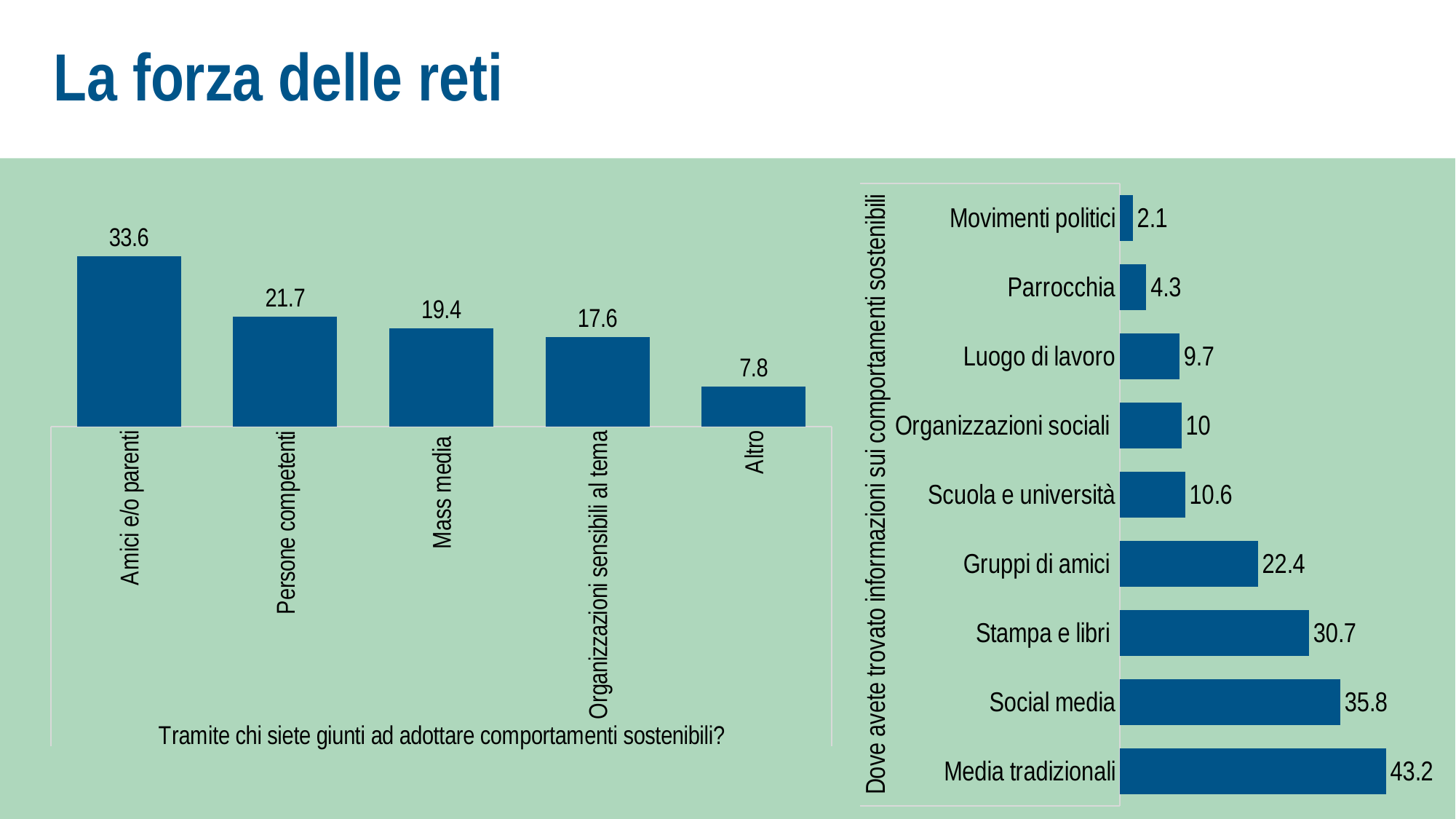
In the left chart 'Tramite chi siete giunti ad adottare comportamenti sostenibili?', how many categories are shown? 5 In the left chart 'Tramite chi siete giunti ad adottare comportamenti sostenibili?', what is the difference between Amici e/o parenti and Persone competenti? 11.9 In the right chart 'Dove avete trovato informazioni sui comportamenti sostenibili', which category has the lowest value? Movimenti politici In the right chart 'Dove avete trovato informazioni sui comportamenti sostenibili', what is the value for Stampa e libri? 30.7 In the right chart 'Dove avete trovato informazioni sui comportamenti sostenibili', how many categories are shown? 9 In the left chart 'Tramite chi siete giunti ad adottare comportamenti sostenibili?', do the values rise or fall from left to right? fall In the right chart 'Dove avete trovato informazioni sui comportamenti sostenibili', which category has the highest value? Media tradizionali In the left chart 'Tramite chi siete giunti ad adottare comportamenti sostenibili?', which category has the lowest value? Altro In the left chart 'Tramite chi siete giunti ad adottare comportamenti sostenibili?', which category has the highest value? Amici e/o parenti In the right chart 'Dove avete trovato informazioni sui comportamenti sostenibili', which is larger: Social media or Gruppi di amici? Social media In the left chart 'Tramite chi siete giunti ad adottare comportamenti sostenibili?', what is the value for Mass media? 19.4 What type of chart is the right chart 'Dove avete trovato informazioni sui comportamenti sostenibili'? bar chart